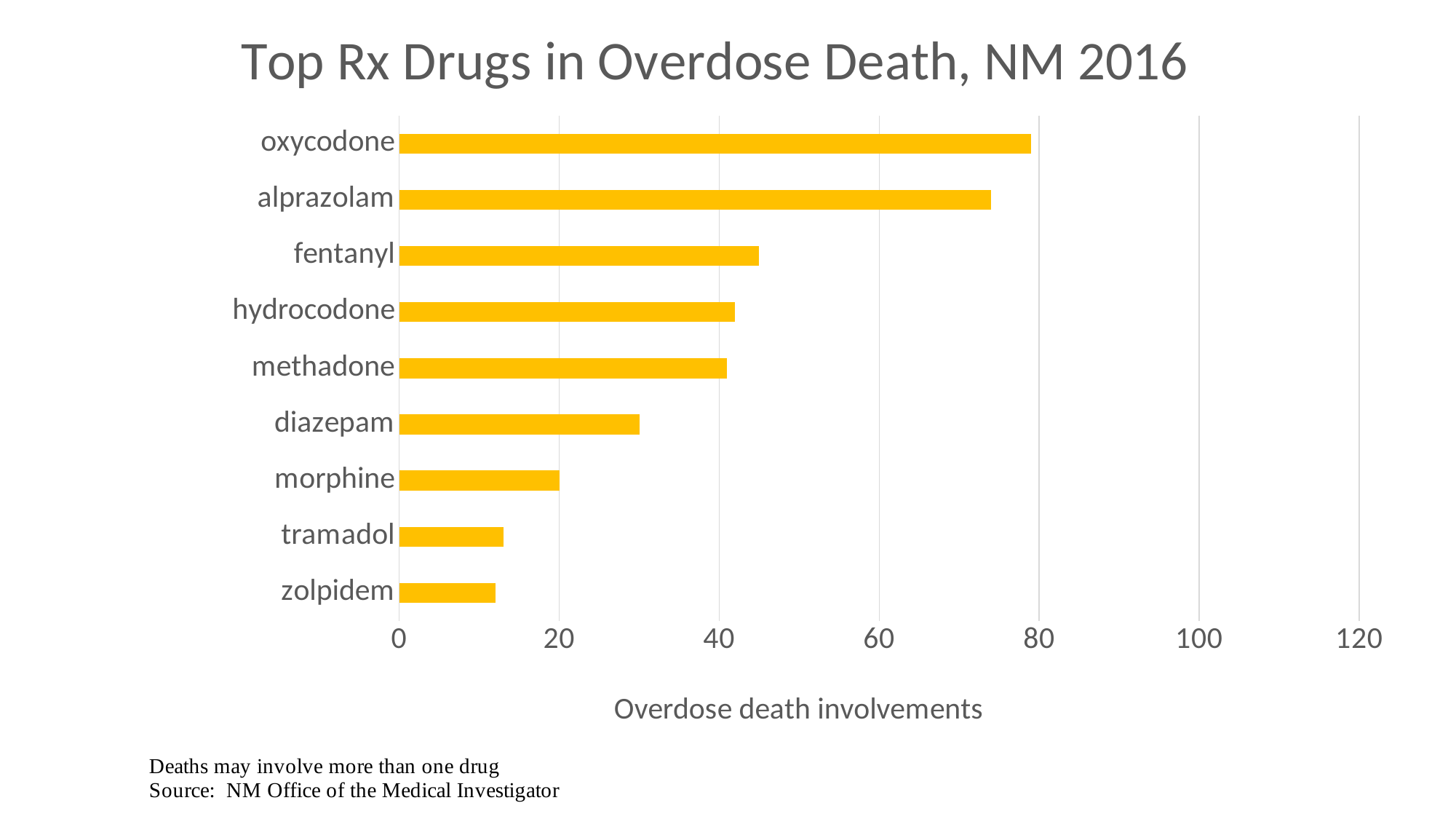
How many drugs are shown in the chart? 9 Is the value for tramadol greater or less than 20? less Is the value for fentanyl greater or less than 40? greater What kind of chart is shown on the slide? bar chart Which has more overdose death involvements, fentanyl or diazepam? fentanyl Is the value for alprazolam greater or less than 80? less Which drug has the highest number of overdose death involvements? oxycodone Which drug has the lowest number of overdose death involvements? zolpidem Which has more overdose death involvements, oxycodone or alprazolam? oxycodone What is the title of the chart? Top Rx Drugs in Overdose Death, NM 2016